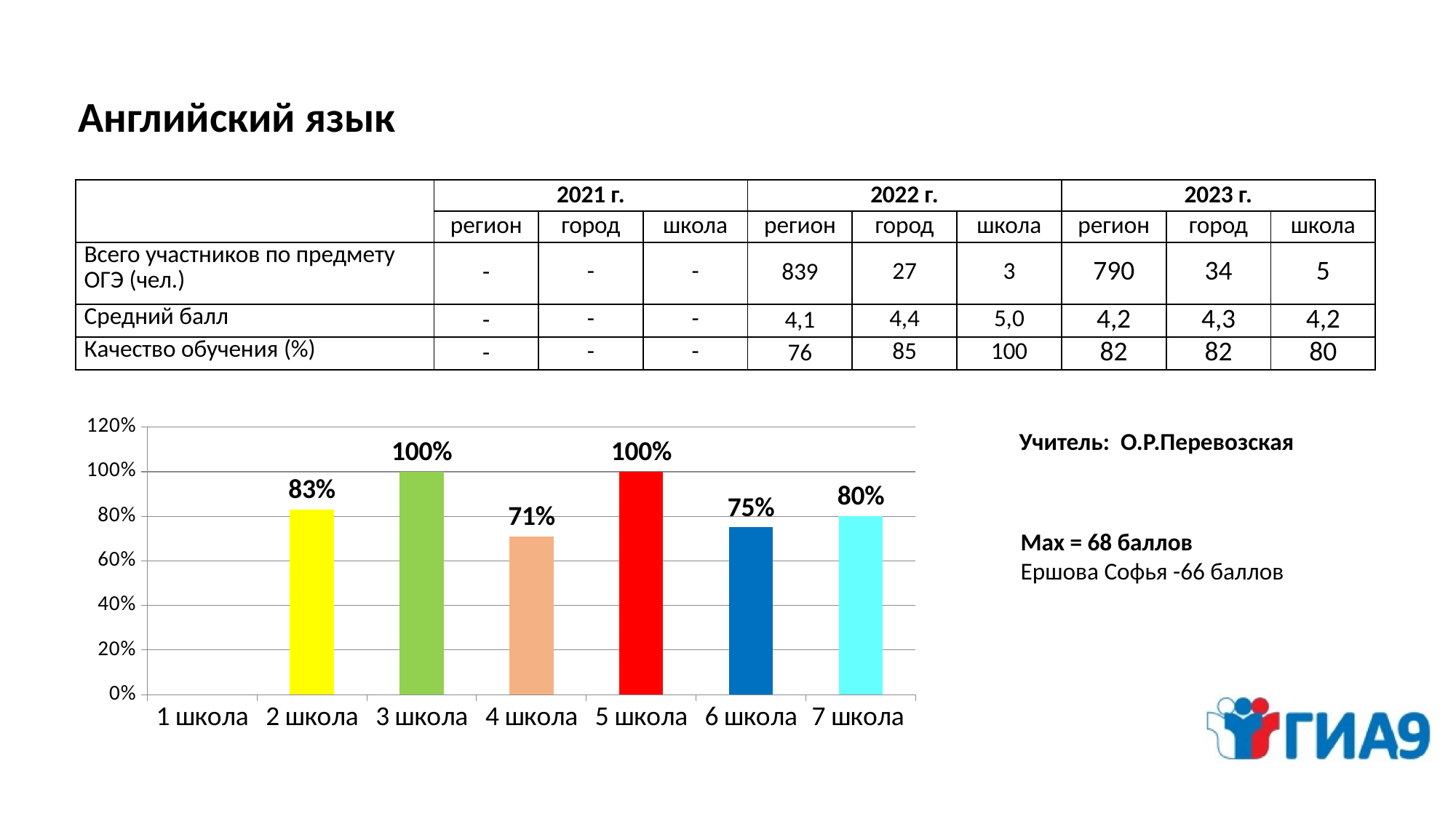
What is the value shown for 7 школа? 80% Which schools have the highest value on the chart? 3 школа and 5 школа What is the value shown for 6 школа? 75% Among the schools with a bar shown, which has the lowest value? 4 школа How many school categories are listed on the x axis of the chart? 7 What is the difference between the values for 2 школа and 4 школа? 12 percentage points What kind of chart is shown on the slide? bar chart Which school category on the x axis has no bar plotted? 1 школа What is the value shown for 4 школа? 71% Which is larger, the value for 6 школа or the value for 7 школа? 7 школа What is the value shown for 2 школа? 83% Is the value for 6 школа greater or less than 80%? less